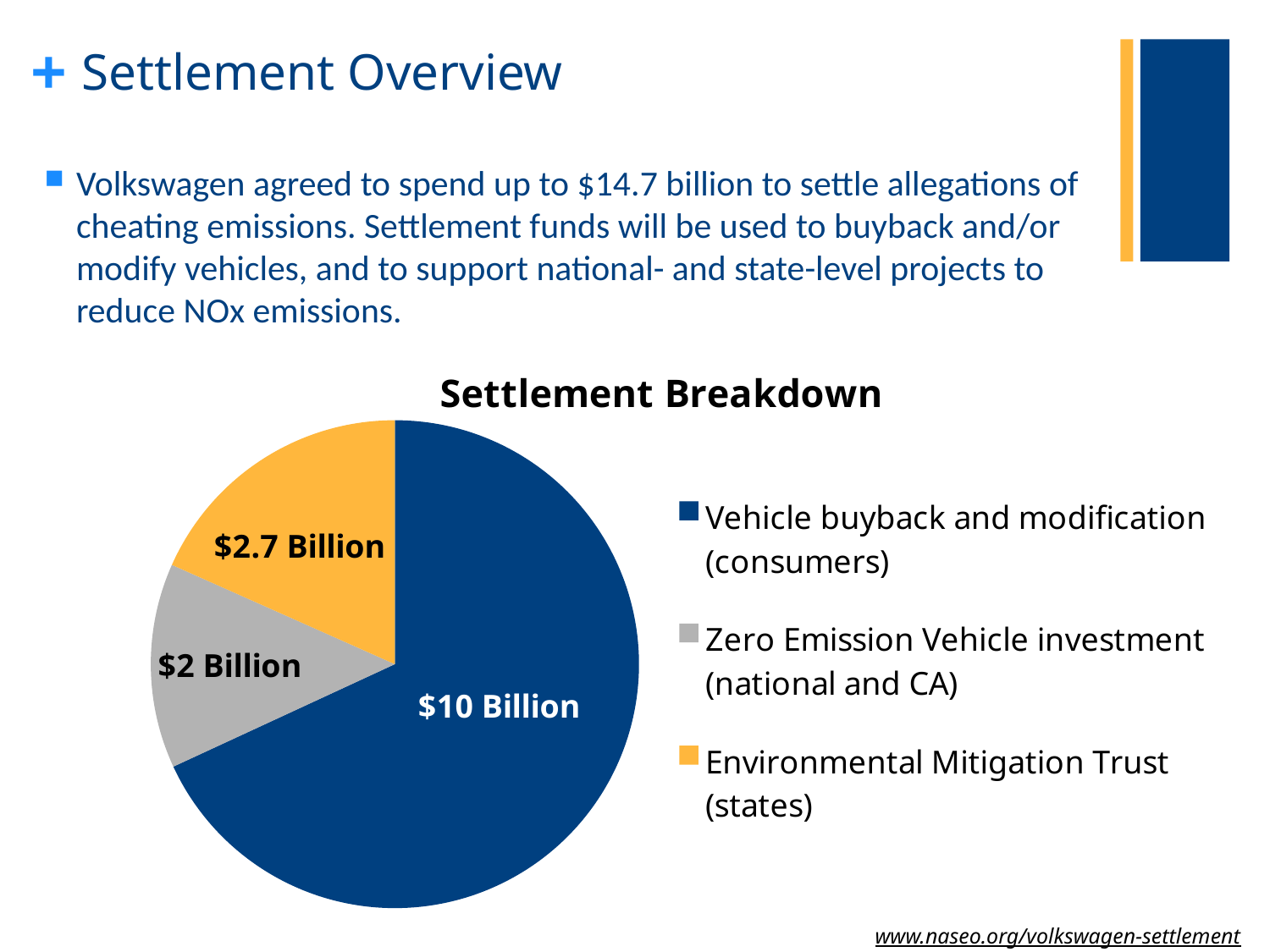
What is the total of all three slices in the Settlement Breakdown chart? $14.7 Billion What is the title of the chart on the slide? Settlement Breakdown What is the value of the Environmental Mitigation Trust (states) slice? $2.7 Billion How many slices does the Settlement Breakdown pie chart have? 3 What type of chart is the Settlement Breakdown chart? pie chart What is the difference between the Vehicle buyback and modification slice and the Environmental Mitigation Trust slice? $7.3 Billion Which category has the smallest slice in the Settlement Breakdown chart? Zero Emission Vehicle investment (national and CA) Which is larger, the Environmental Mitigation Trust (states) slice or the Zero Emission Vehicle investment (national and CA) slice? Environmental Mitigation Trust (states) What is the value of the Zero Emission Vehicle investment (national and CA) slice? $2 Billion How many entries does the legend of the Settlement Breakdown chart list? 3 What is the value of the Vehicle buyback and modification (consumers) slice? $10 Billion Which category has the largest slice in the Settlement Breakdown chart? Vehicle buyback and modification (consumers)